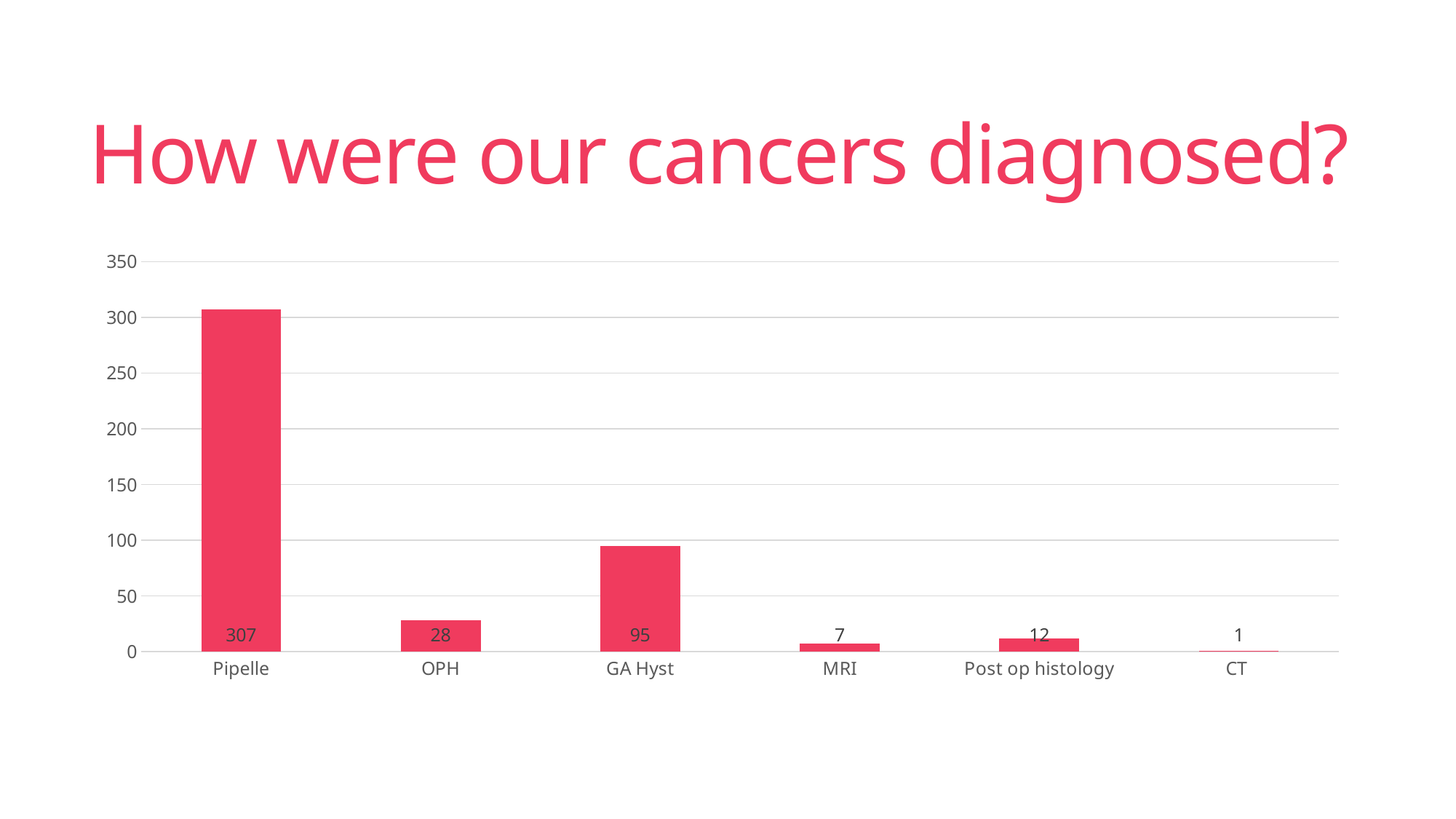
What is the value for Pipelle? 307 Which category has the highest value? Pipelle What is the value for Post op histology? 12 How many categories are shown on the x axis? 6 What is the value for GA Hyst? 95 Is the value for Pipelle greater or less than 300? greater What is the value for CT? 1 Which category has the lowest value? CT What kind of chart is shown on the slide? Bar chart What is the difference between the values for Pipelle and GA Hyst? 212 Which is larger, the value for OPH or the value for Post op histology? OPH What is the difference between the values for OPH and MRI? 21